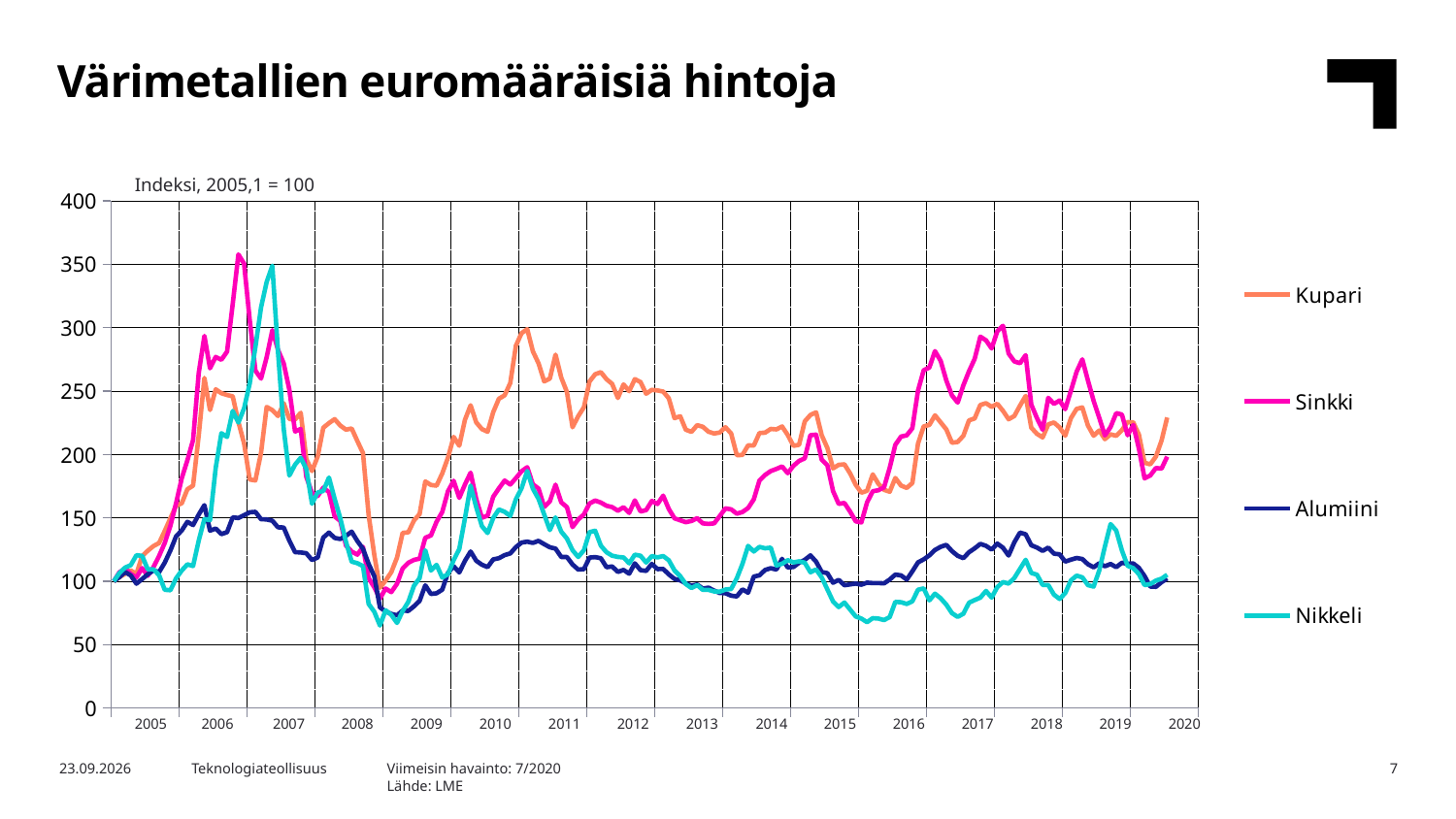
Which series is lower during 2016, Nikkeli or Alumiini? Nikkeli What kind of chart is shown on the slide? line chart Is the lowest value of Nikkeli around 2008–2009 greater or less than 100? less Is the value of Alumiini in 2017 greater or less than 200? less How many year labels are shown on the x axis? 16 What is the title of the chart on the slide? Värimetallien euromääräisiä hintoja Does the Kupari series rise or fall between 2008 and early 2009? fall How many series does the legend list? 4 Is the peak value of Sinkki around 2006 greater or less than 300? greater What index base is stated above the chart? Indeksi, 2005,1 = 100